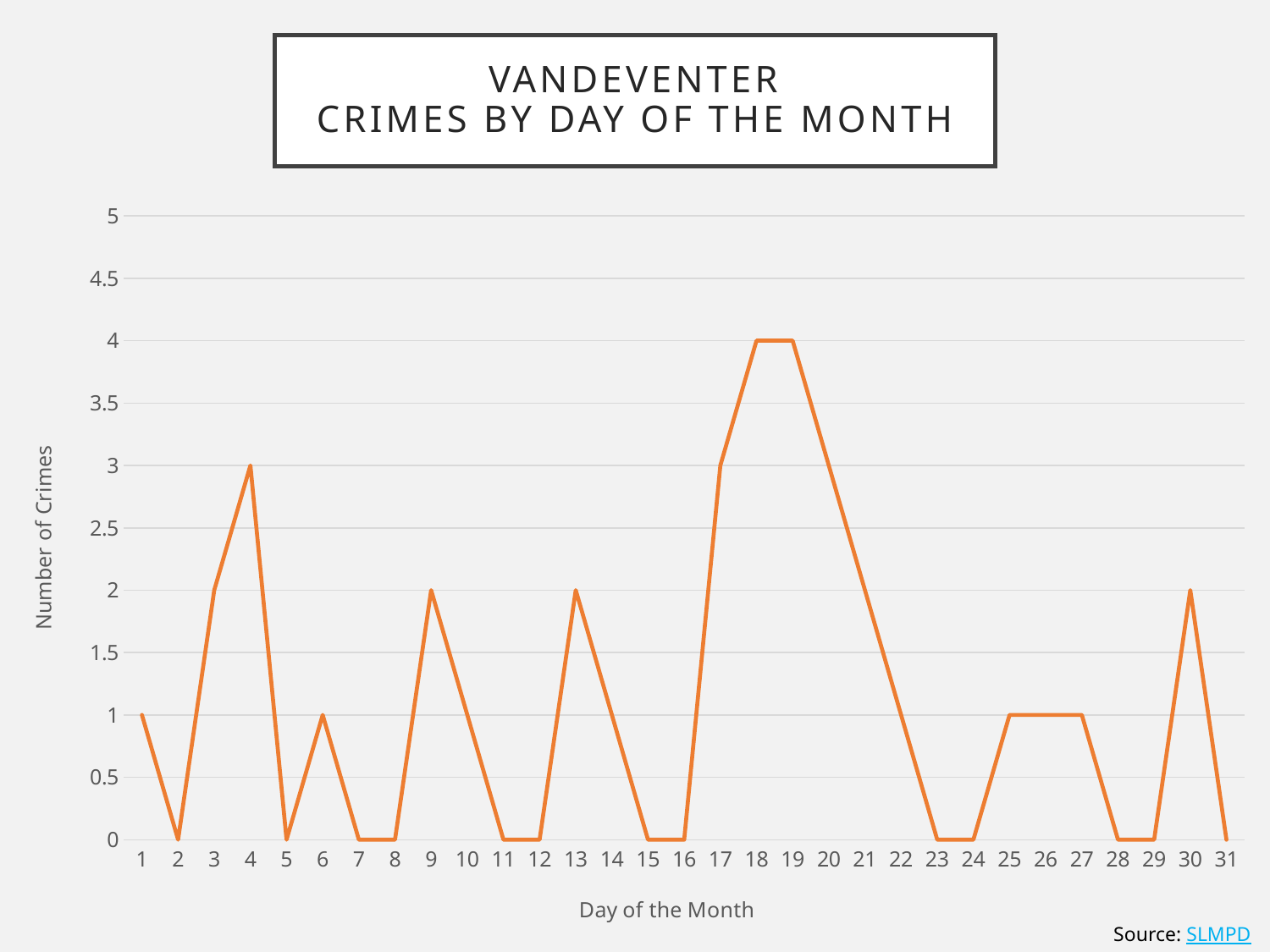
What is the label of the y axis? Number of Crimes How many days of the month are shown on the x axis? 31 How many crimes were recorded on day 30? 2 What type of chart is shown on the slide? Line chart How many crimes were recorded on day 4? 3 Do the number of crimes rise or fall from day 16 to day 18? Rise How many crimes were recorded on day 2? 0 Which day had more crimes, day 9 or day 17? Day 17 What is the highest number of crimes recorded on any single day? 4 What is the difference in the number of crimes between day 18 and day 4? 1 What is the title of the chart? Vandeventer Crimes by Day of the Month How many crimes were recorded on day 18? 4